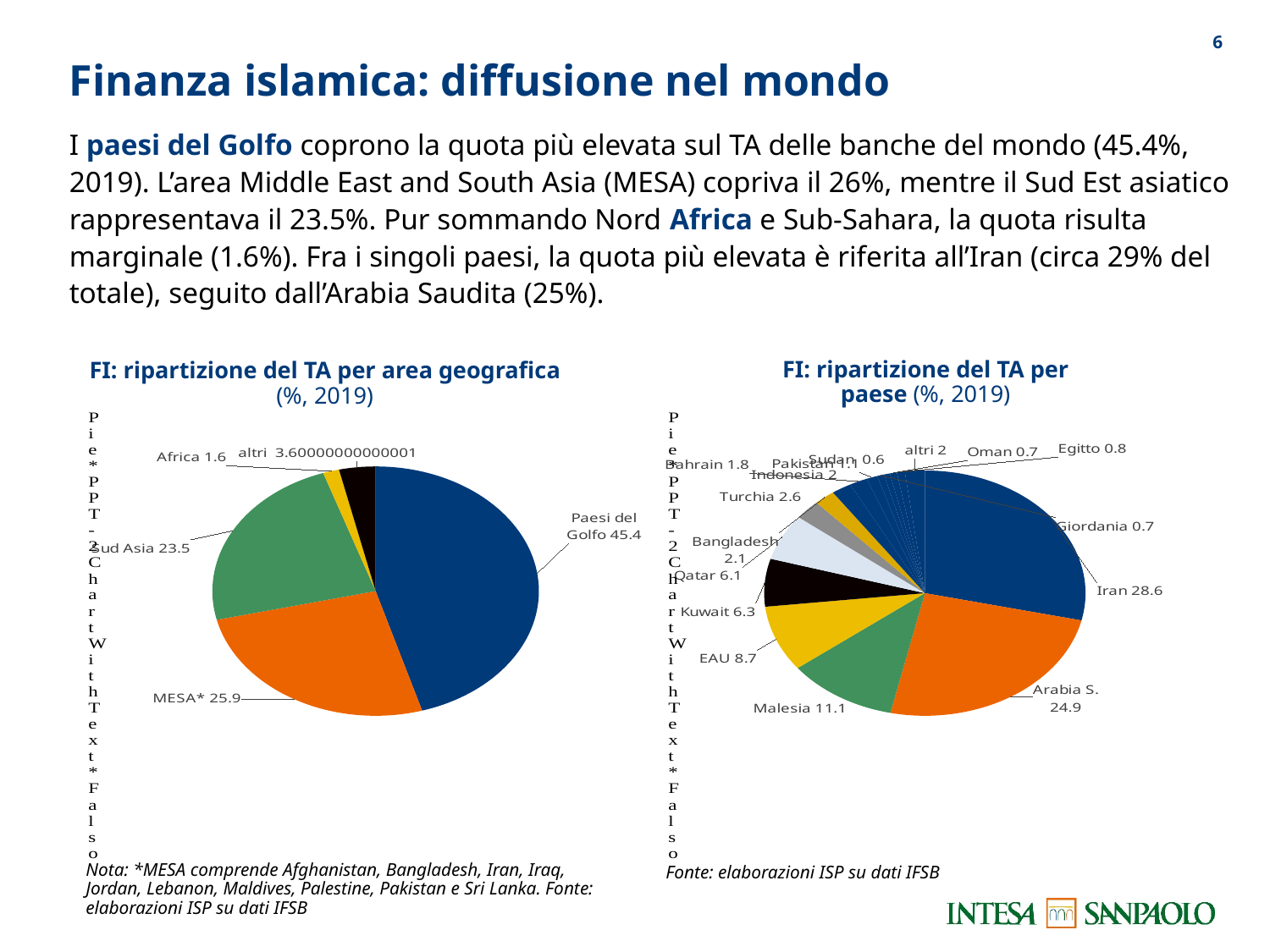
In the chart 'FI: ripartizione del TA per area geografica', what is the value for MESA*? 25.9 In the chart 'FI: ripartizione del TA per area geografica', what is the difference between Paesi del Golfo and Sud Asia? 21.9 In the chart 'FI: ripartizione del TA per area geografica', which area has the smallest share? Africa In the chart 'FI: ripartizione del TA per paese', what is the value for Malesia? 11.1 In the chart 'FI: ripartizione del TA per area geografica', how many slices does the pie have? 5 In the chart 'FI: ripartizione del TA per paese', which country has the largest share? Iran In the chart 'FI: ripartizione del TA per paese', what is the difference between Iran and Arabia S.? 3.7 In the chart 'FI: ripartizione del TA per area geografica', what is the value for Paesi del Golfo? 45.4 In the chart 'FI: ripartizione del TA per paese', what is the value for EAU? 8.7 In the chart 'FI: ripartizione del TA per paese', which is larger, Kuwait or Qatar? Kuwait In the chart 'FI: ripartizione del TA per paese', what is the value for Iran? 28.6 What kind of chart is 'FI: ripartizione del TA per area geografica'? Pie chart